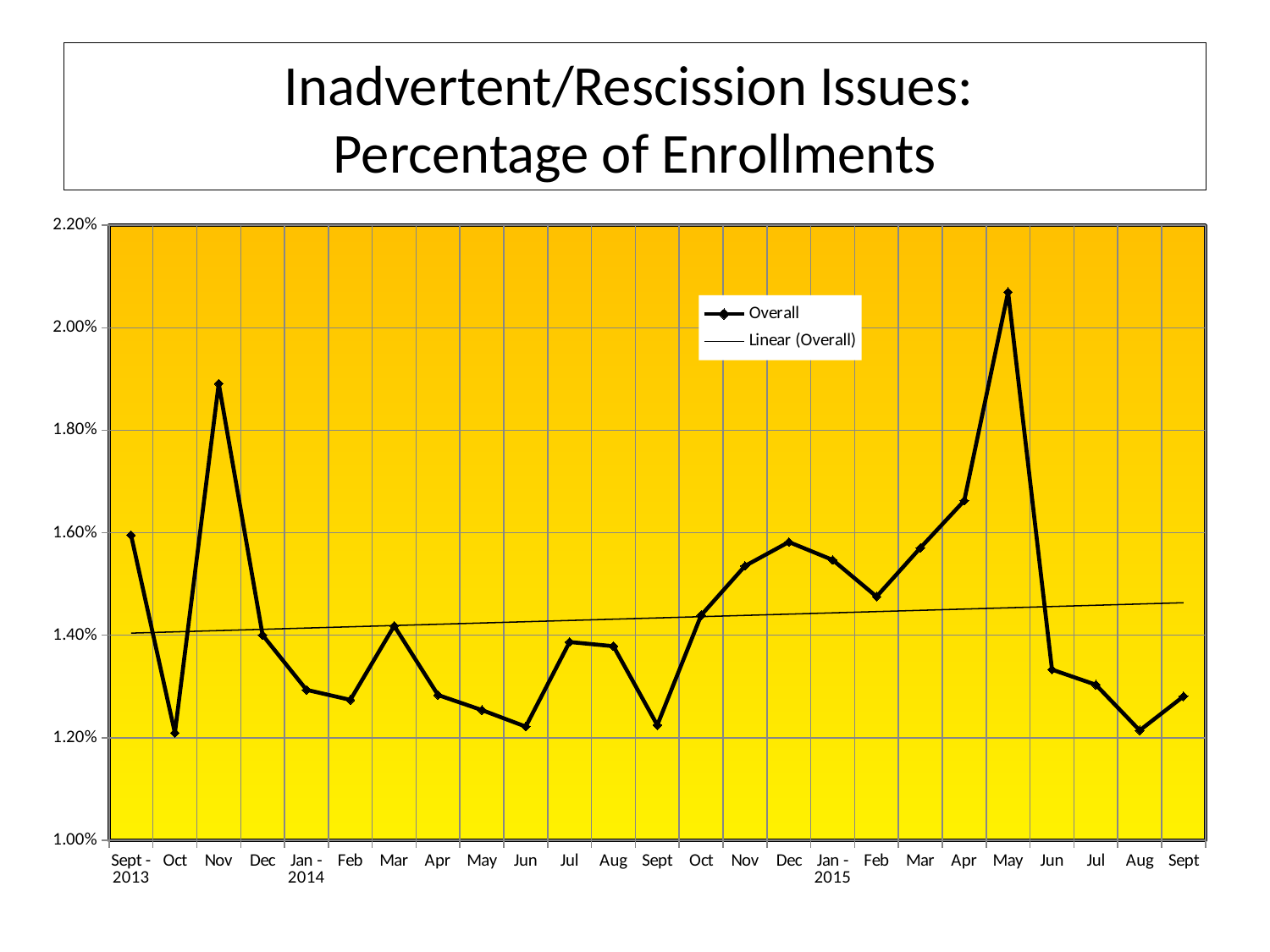
How many entries does the legend list? 2 Is the Overall value for May 2015 greater or less than 2.00%? greater Does the Linear (Overall) trendline rise or fall from left to right? Rises Is the Overall value for Apr 2015 greater or less than 1.60%? greater How many monthly data points are plotted on the Overall line? 25 Is the Overall value for Jun 2014 greater or less than 1.40%? less What are the two entries in the legend? Overall and Linear (Overall) What kind of chart is shown on the slide? Line chart Which is larger, the Overall value for Nov 2013 or for Dec 2013? Nov 2013 Which month has the highest Overall value? May 2015